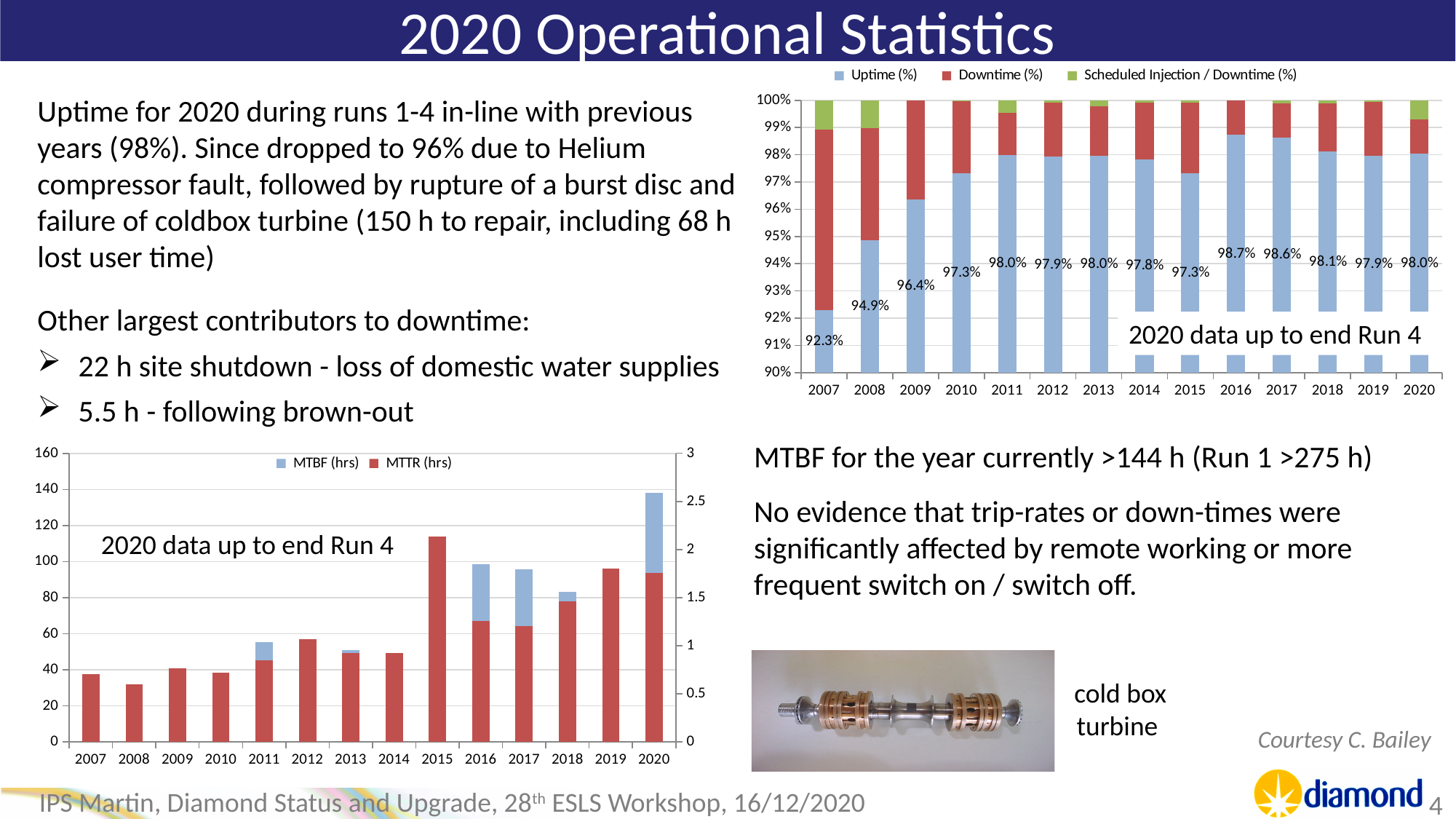
In the uptime chart (top right), which year has the highest uptime? 2016 In the uptime chart (top right), what is the difference in uptime between 2008 and 2007? 2.6% In the uptime chart (top right), how many years are shown on the x axis? 14 In the uptime chart (top right), which year has the lowest uptime? 2007 What kind of chart is the MTBF/MTTR chart (bottom left)? Bar chart In the uptime chart (top right), what is the uptime percentage for 2016? 98.7% In the uptime chart (top right), what is the uptime percentage for 2020? 98.0% In the MTBF/MTTR chart (bottom left), how many series does the legend list? 2 In the uptime chart (top right), which year has higher uptime, 2009 or 2010? 2010 In the uptime chart (top right), how many series does the legend list? 3 In the uptime chart (top right), what is the uptime percentage for 2007? 92.3% In the MTBF/MTTR chart (bottom left), which year has the tallest bar? 2020